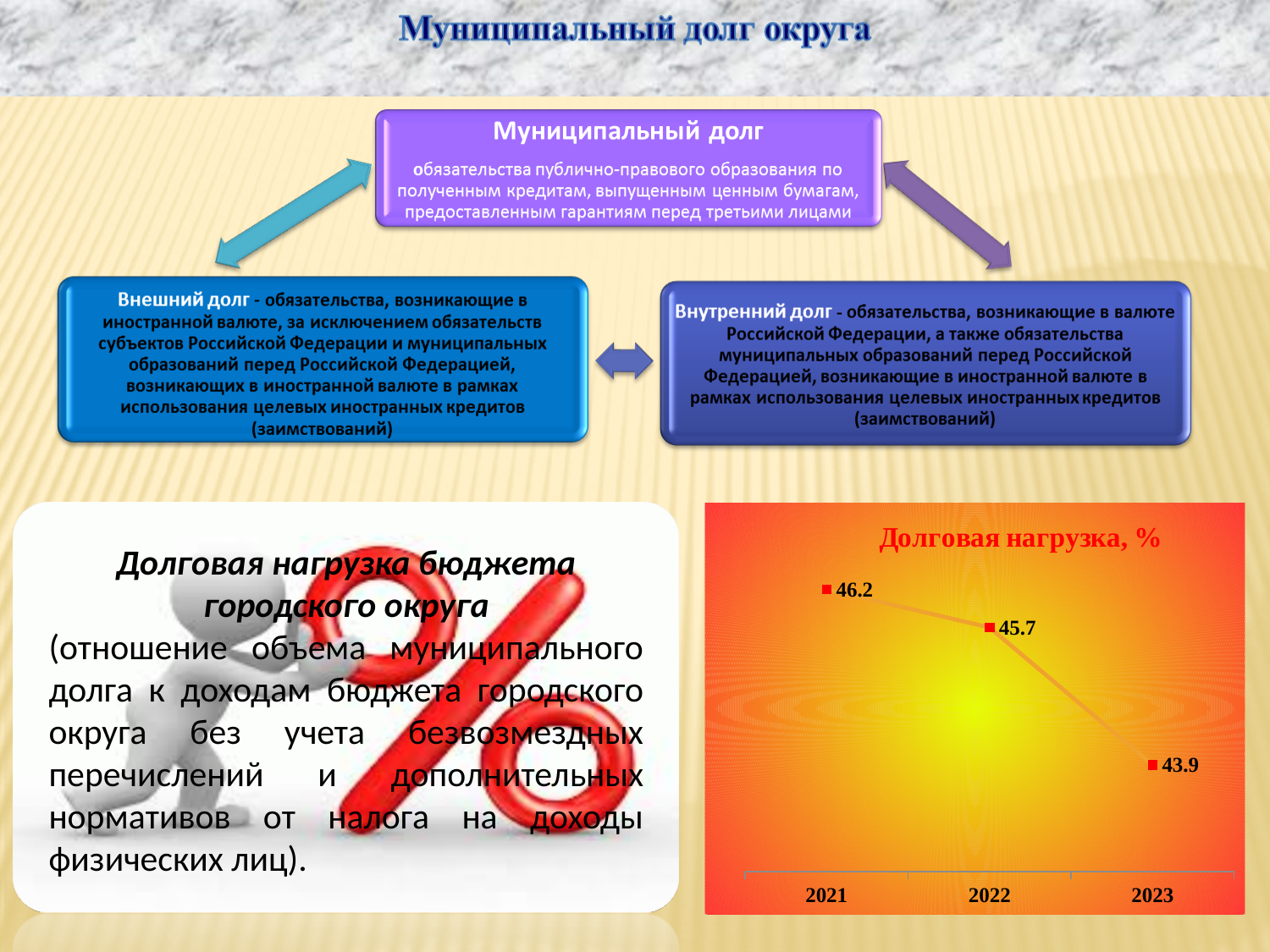
Do the values in the 'Долговая нагрузка, %' chart rise or fall from 2021 to 2023? fall What is the title of the chart on the slide? Долговая нагрузка, % What is the difference between the 2021 and 2023 values in the 'Долговая нагрузка, %' chart? 2.3 What is the value for 2022 in the 'Долговая нагрузка, %' chart? 45.7 What is the value for 2023 in the 'Долговая нагрузка, %' chart? 43.9 What kind of chart is 'Долговая нагрузка, %'? line chart What is the value for 2021 in the 'Долговая нагрузка, %' chart? 46.2 In the 'Долговая нагрузка, %' chart, which is larger: the value for 2021 or the value for 2022? 2021 Which year has the highest value in the 'Долговая нагрузка, %' chart? 2021 Which year has the lowest value in the 'Долговая нагрузка, %' chart? 2023 How many years are plotted in the 'Долговая нагрузка, %' chart? 3 What is the difference between the 2022 and 2023 values in the 'Долговая нагрузка, %' chart? 1.8